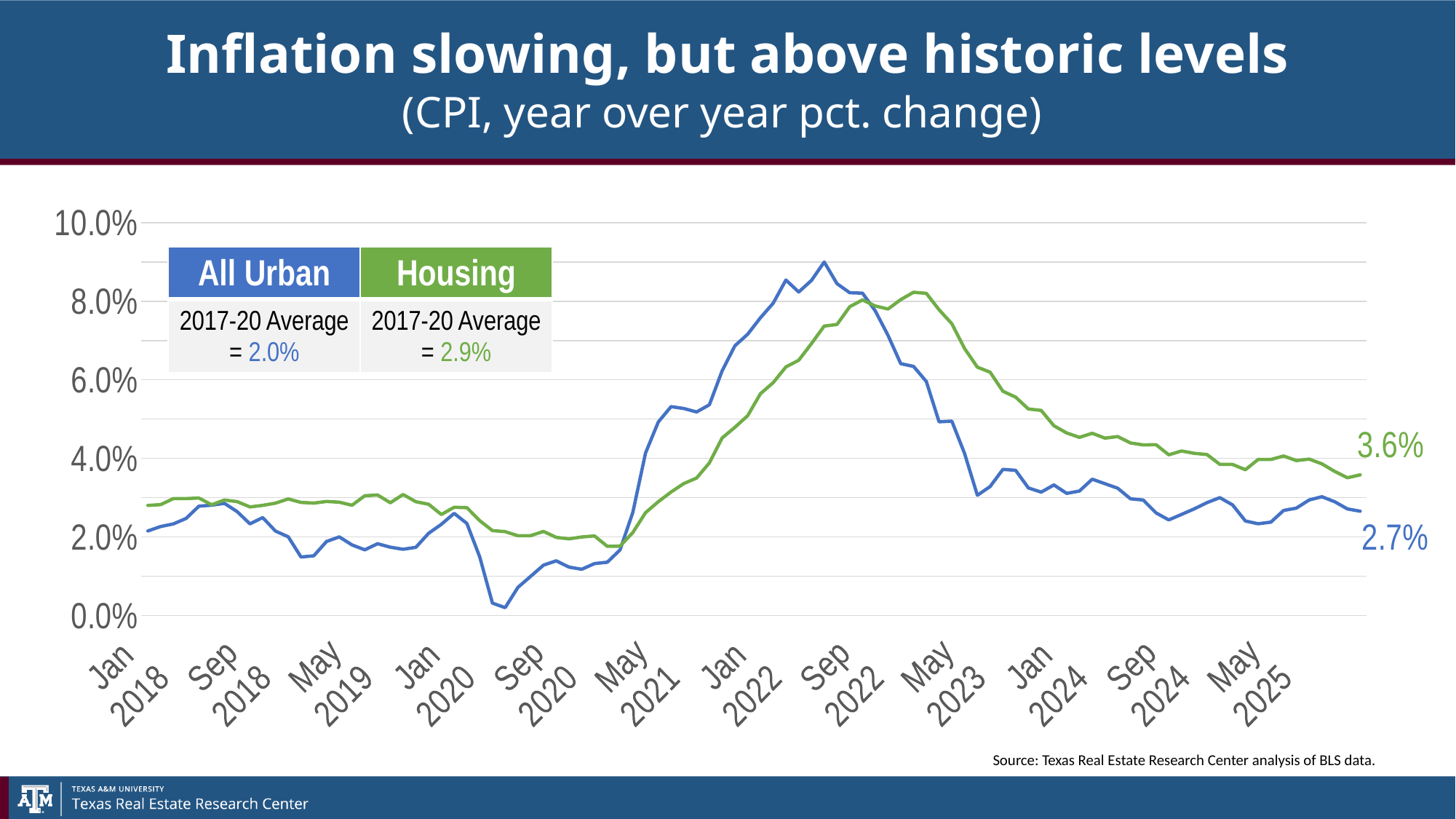
What kind of chart is shown on the slide? line chart At the end of the chart, which series is higher, All Urban or Housing? Housing From Sep 2022 to May 2025, does the All Urban series generally rise or fall? fall What is the latest labelled value for the All Urban series? 2.7% Is the lowest value of the All Urban series, around Sep 2020, greater or less than 1.0%? less What 2017-20 average is shown for the Housing series in the legend? 2.9% Which series reaches the highest value anywhere on the chart? All Urban Is the peak value of the All Urban series greater or less than 8.0%? greater How many series does the chart's legend list? 2 What is the latest labelled value for the Housing series? 3.6% In Jan 2022, which series is higher, All Urban or Housing? All Urban What is the difference between the latest labelled Housing value and the latest labelled All Urban value? 0.9%